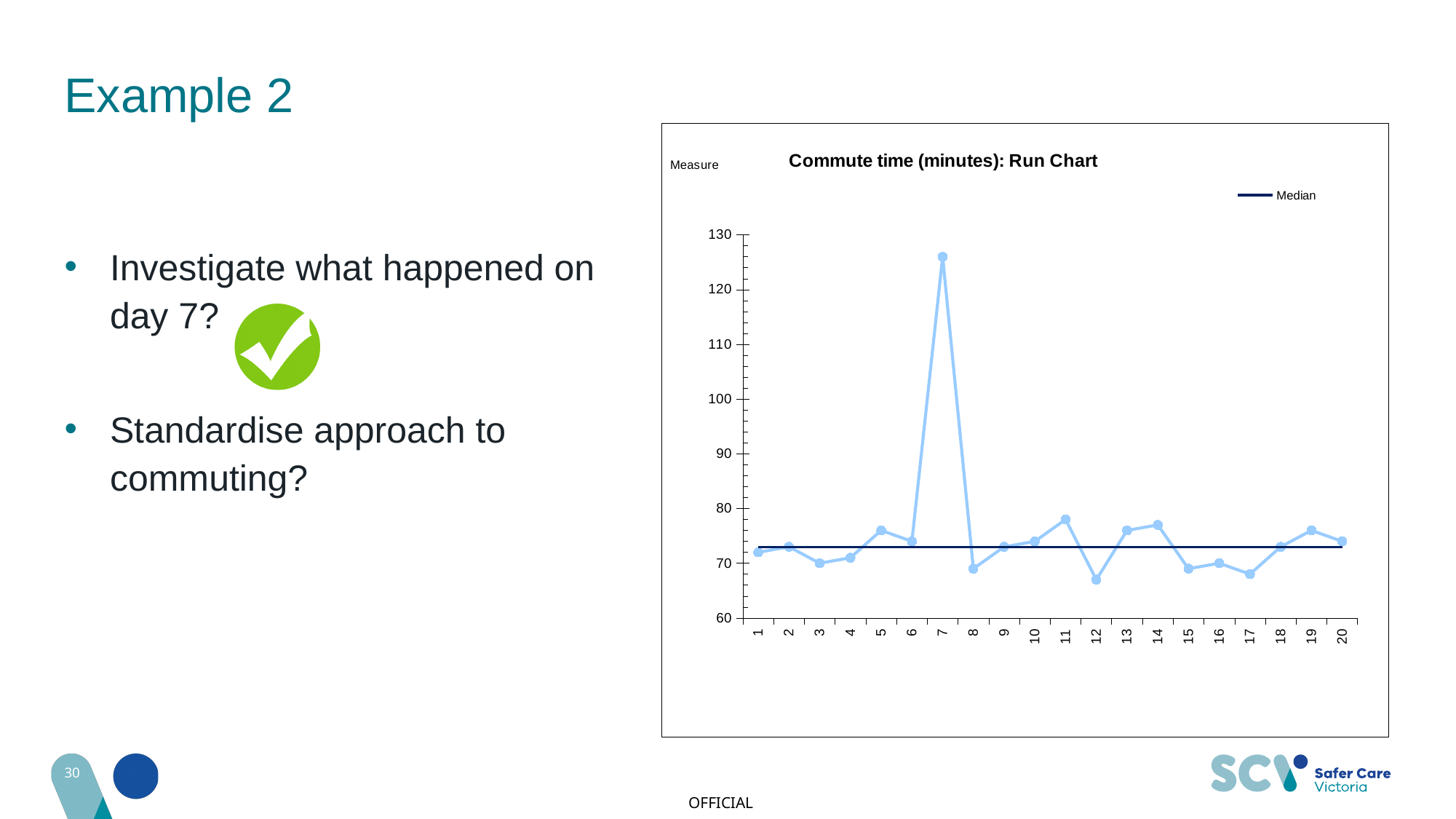
Which x-axis point has the highest value? 7 Is the value at point 11 greater or less than 70? greater Is the value at point 5 greater or less than 80? less Is the value at point 7 greater or less than 120? greater What entry does the legend list? Median How many data points are plotted along the x axis? 20 What is the title of the chart? Commute time (minutes): Run Chart What is the highest value shown on the y axis? 130 Which has the larger value, point 7 or point 1? 7 Which has the larger value, point 11 or point 12? 11 What kind of chart is shown on the slide? line chart